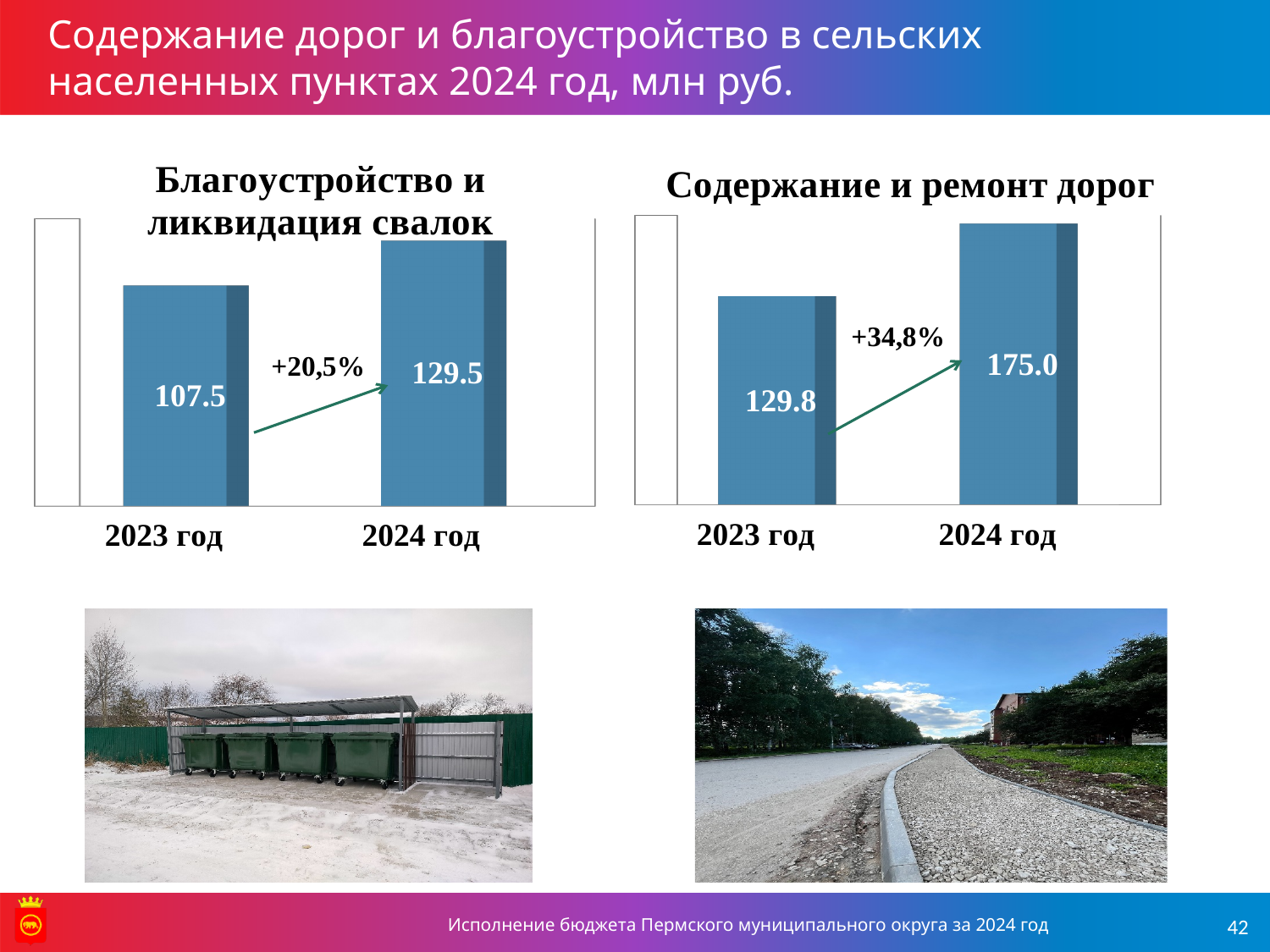
Which is larger: the 2024 год value in the 'Благоустройство и ликвидация свалок' chart or the 2023 год value in the 'Содержание и ремонт дорог' chart? 2023 год in Содержание и ремонт дорог In the chart titled 'Содержание и ремонт дорог', what percentage change is shown between 2023 год and 2024 год? +34,8% In the chart titled 'Содержание и ремонт дорог', what is the value for 2024 год? 175.0 In the chart titled 'Содержание и ремонт дорог', what is the difference between the 2024 год and 2023 год values? 45.2 In the chart titled 'Благоустройство и ликвидация свалок', which year has the lowest value? 2023 год In the chart titled 'Благоустройство и ликвидация свалок', what is the difference between the 2024 год and 2023 год values? 22.0 What kind of chart is the chart titled 'Благоустройство и ликвидация свалок'? bar chart In the chart titled 'Благоустройство и ликвидация свалок', what is the value for 2023 год? 107.5 In the chart titled 'Содержание и ремонт дорог', which year has the highest value? 2024 год How many categories does the chart titled 'Содержание и ремонт дорог' show? 2 In the chart titled 'Благоустройство и ликвидация свалок', what is the value for 2024 год? 129.5 In the chart titled 'Содержание и ремонт дорог', what is the value for 2023 год? 129.8